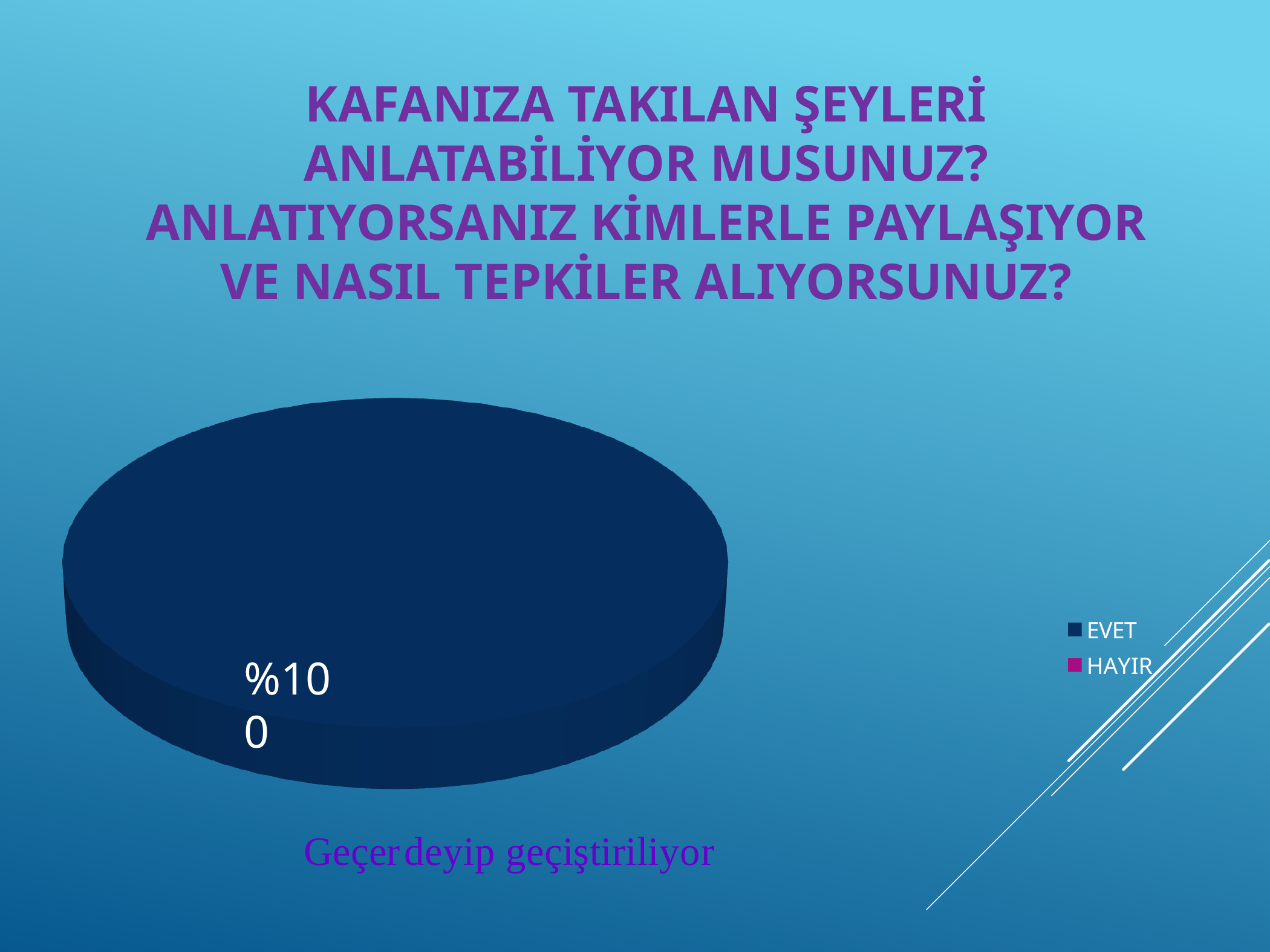
How many data labels are printed on the pie chart? 1 Which legend entry is shown in dark blue? EVET Which legend entry is shown in magenta? HAYIR How many categories does the legend of the pie chart list? 2 Which category has the largest share of the pie chart? EVET Which category has the smaller share of the pie chart, EVET or HAYIR? HAYIR What share of the pie does the EVET slice take up? %100 What kind of chart is shown on the slide? pie chart What percentage is printed on the pie chart for EVET? %100